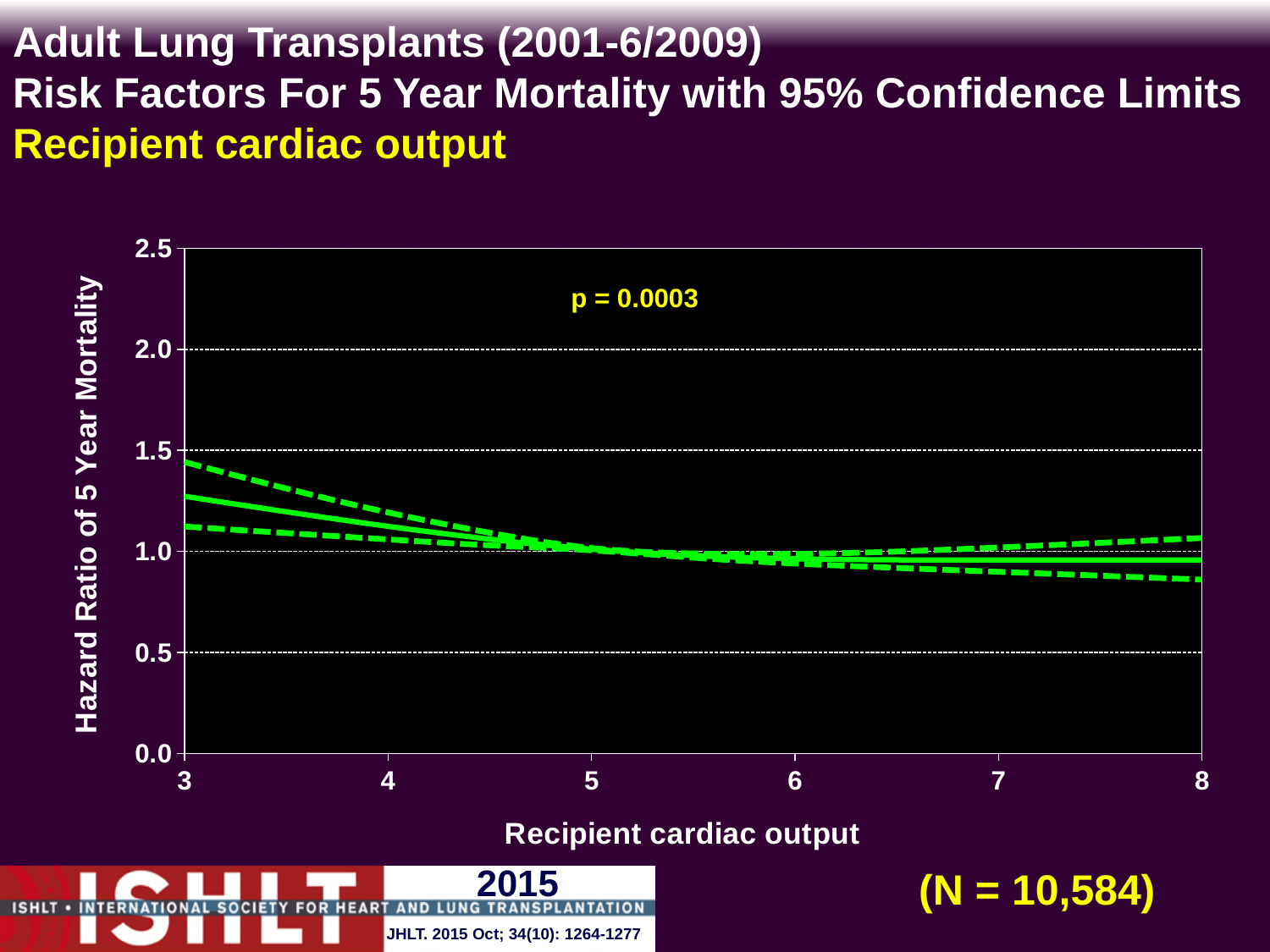
Is the solid hazard ratio line at a recipient cardiac output of 3 greater or less than 1.5? less Is the lower dashed confidence limit at a recipient cardiac output of 8 greater or less than 1.0? less Is the solid hazard ratio line higher at a recipient cardiac output of 3 or at 8? 3 Does the solid hazard ratio line rise or fall as recipient cardiac output increases from 3 to 5? fall What kind of chart is shown on the slide? line chart How many lines are plotted on the chart? 3 What is the lowest recipient cardiac output value shown on the x axis? 3 What is the p-value printed on the chart? p = 0.0003 Is the upper dashed confidence limit at a recipient cardiac output of 3 greater or less than 1.5? less What is the highest value shown on the y axis? 2.5 What is the sample size (N) shown on the slide? N = 10,584